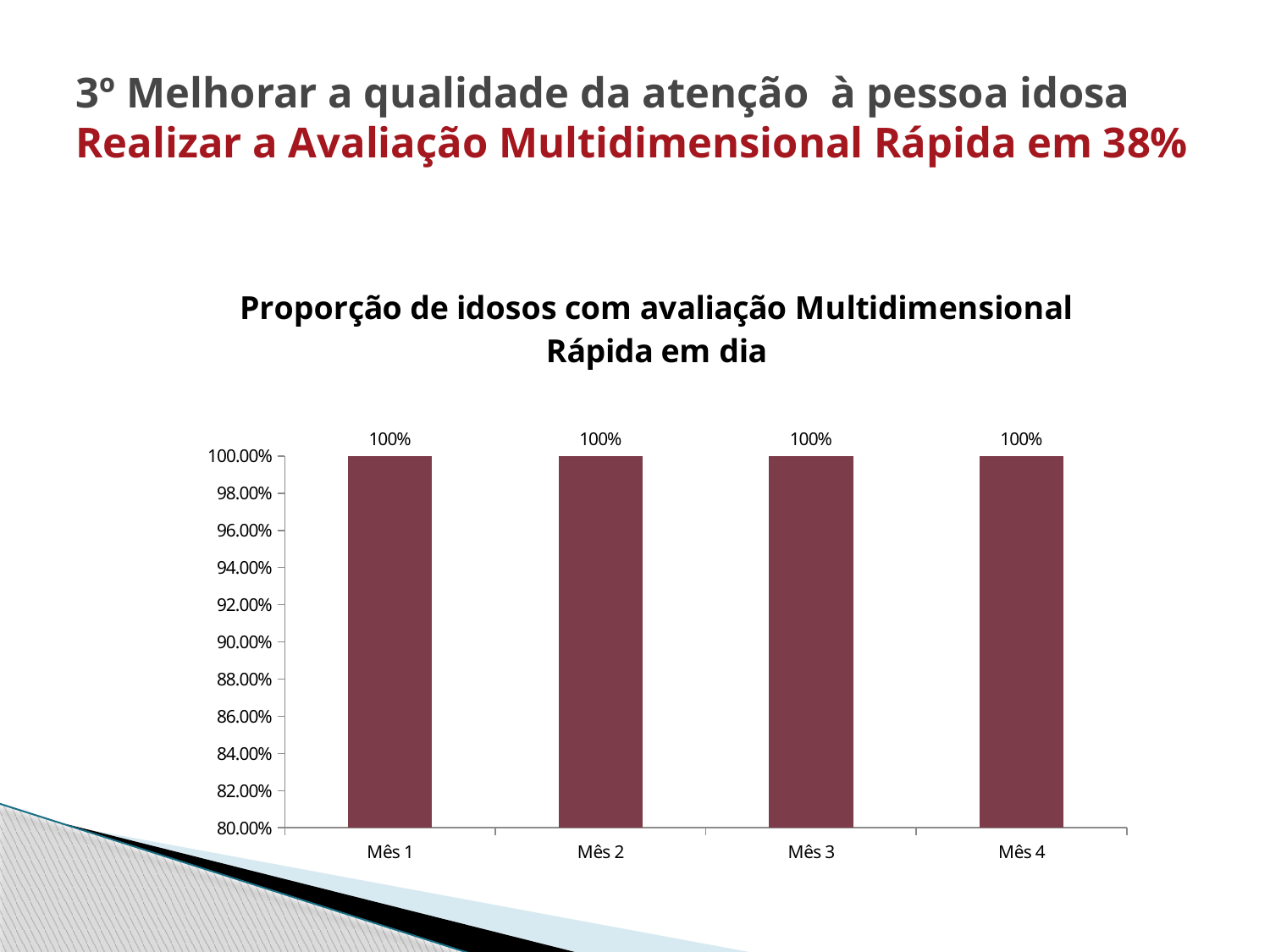
Is the value for Mês 2 greater or less than 90.00%? greater Do the values rise, fall, or stay the same from Mês 1 to Mês 4? Stay the same What is the value for Mês 4? 100% What kind of chart is shown on the slide? Bar chart How many categories (months) are shown on the x axis? 4 What is the lowest value shown on the y axis? 80.00% What is the title of the chart? Proporção de idosos com avaliação Multidimensional Rápida em dia What is the value for Mês 3? 100% What is the value for Mês 2? 100% What is the difference between the values for Mês 1 and Mês 4? 0% What is the value for Mês 1? 100%